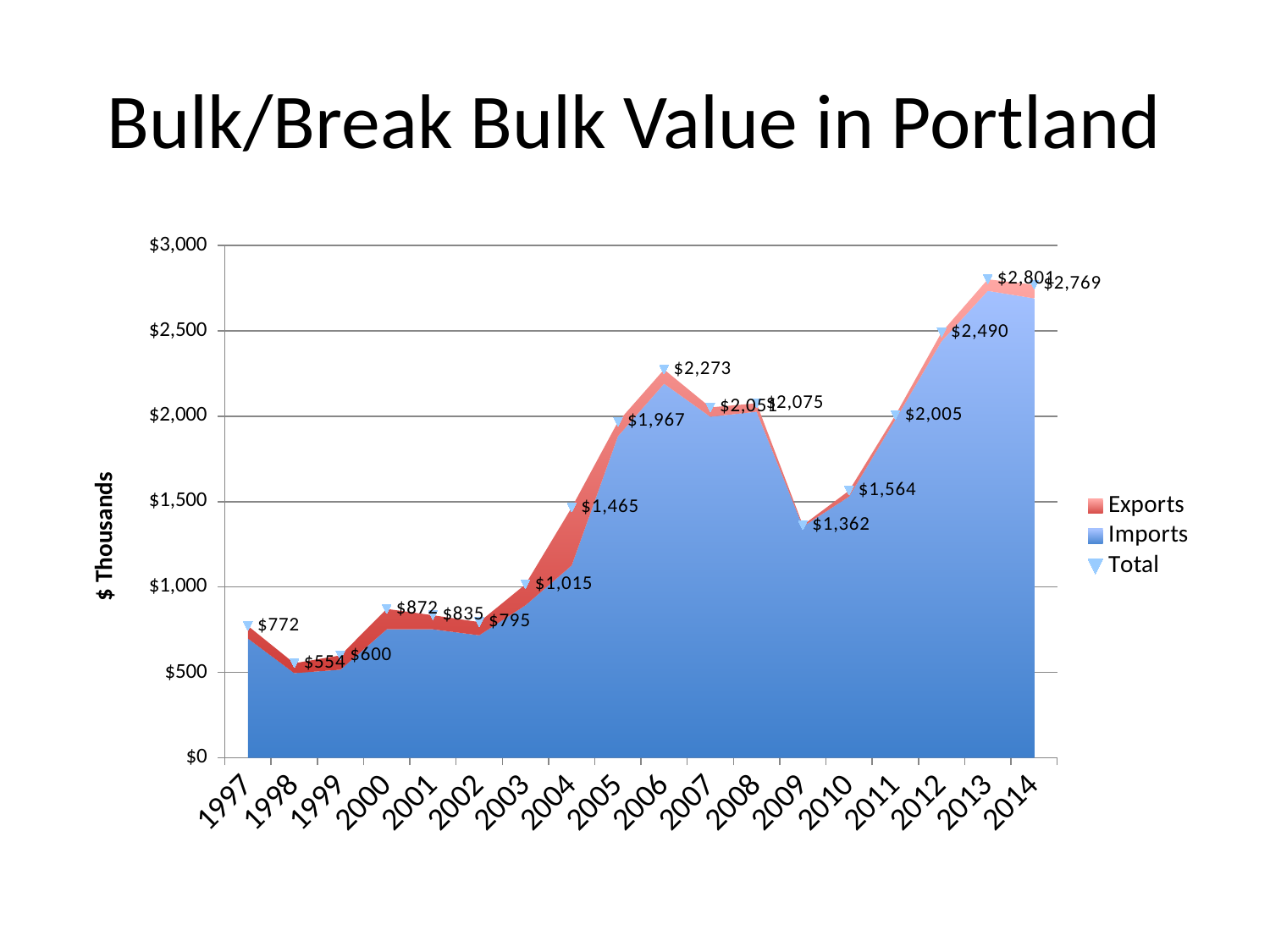
What is the Total value for 2012? $2,490 Which year has the highest Total value? 2013 Which year has the lowest Total value? 1998 How many series does the legend list? 3 Is the Total value for 2004 greater or less than $1,500? less What is the label on the vertical axis? $ Thousands What is the Total value for 1997? $772 What is the difference between the Total values for 2013 and 2009? $1,439 How many years are shown on the x axis? 18 What is the Total value for 2006? $2,273 Which year has a larger Total value, 2005 or 2011? 2011 What kind of chart is shown on the slide? area chart